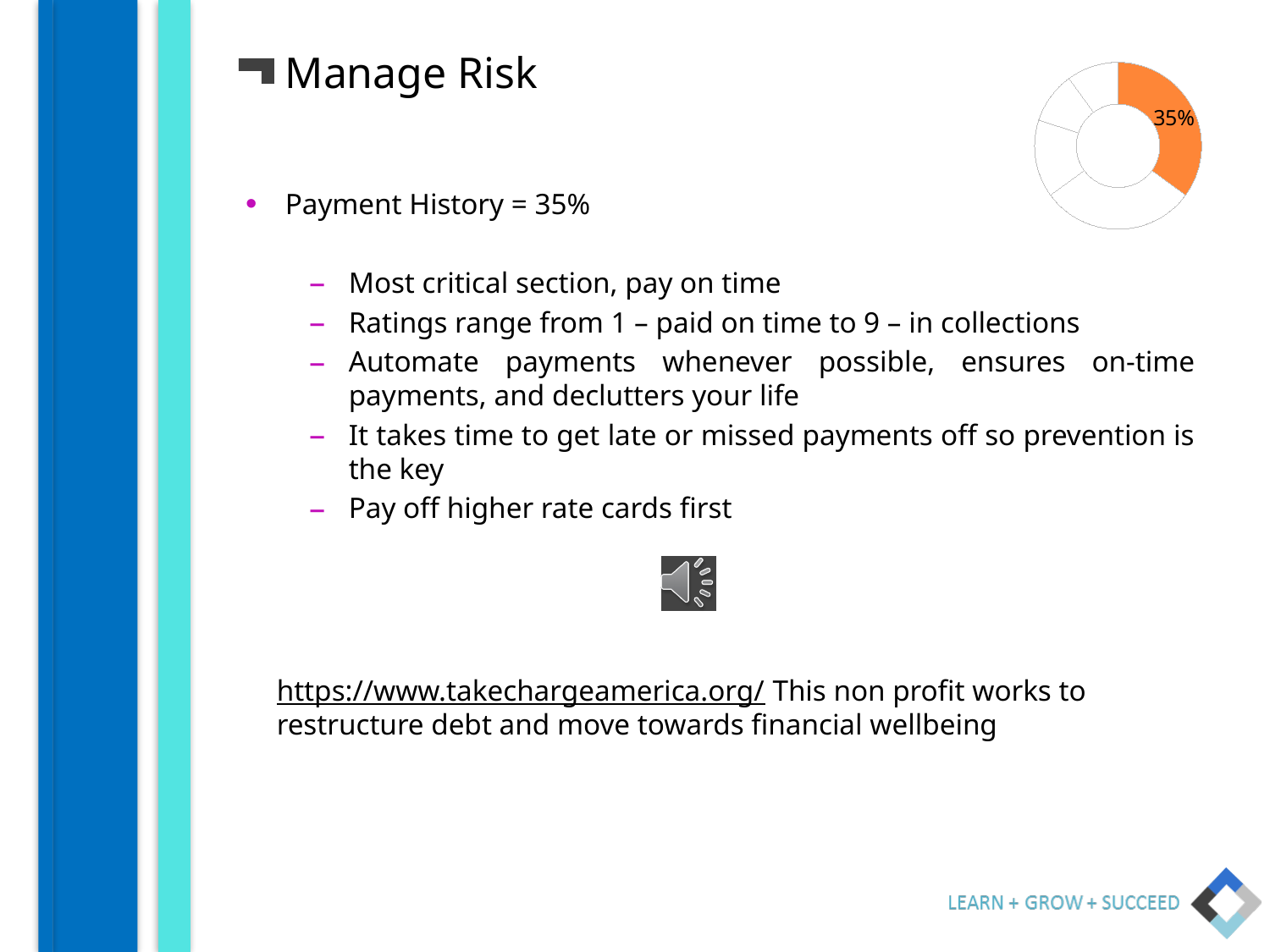
What kind of chart is shown in the top right of the slide? Doughnut (pie) chart How many slices does the doughnut chart have in total? 5 What percentage is printed on the highlighted slice of the doughnut chart? 35% What colour is the slice of the doughnut chart that carries the 35% label? Orange According to the slide, which credit score factor does the 35% slice of the doughnut chart represent? Payment History How many slices of the doughnut chart have a data label printed on them? 1